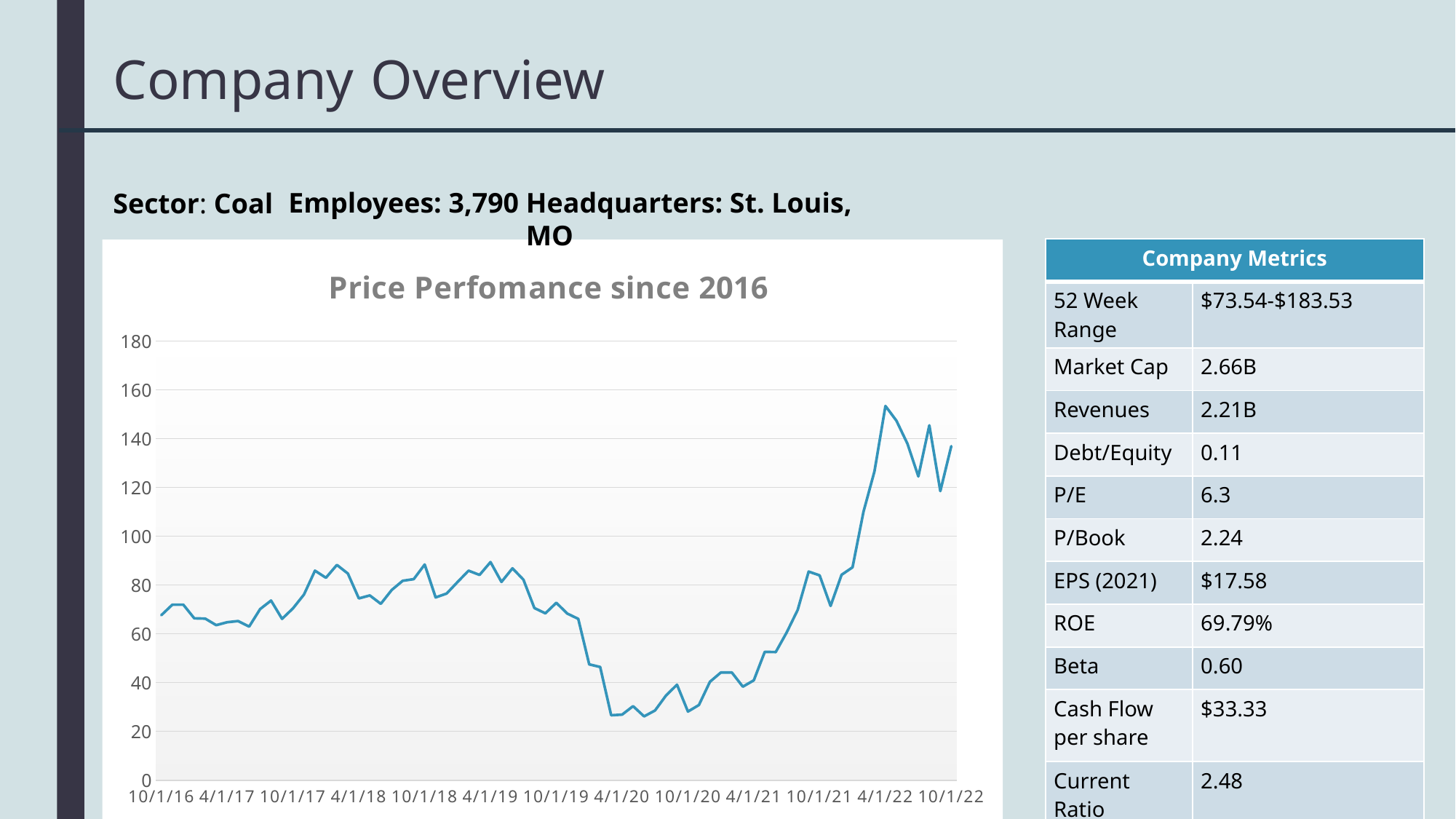
Is the value at 10/1/22 greater or less than 100? greater Is the value at 10/1/16 greater or less than 80? less In which year does the line reach its highest point? 2022 Does the line rise or fall between 4/1/21 and 4/1/22? rise What is the title of the chart on the slide? Price Perfomance since 2016 What kind of chart is shown on the slide? line chart Does the line rise or fall between 10/1/19 and 4/1/20? fall Is the value at 10/1/20 greater or less than 60? less How many date labels are shown along the x axis of the chart? 13 What is the first date label on the x axis of the chart? 10/1/16